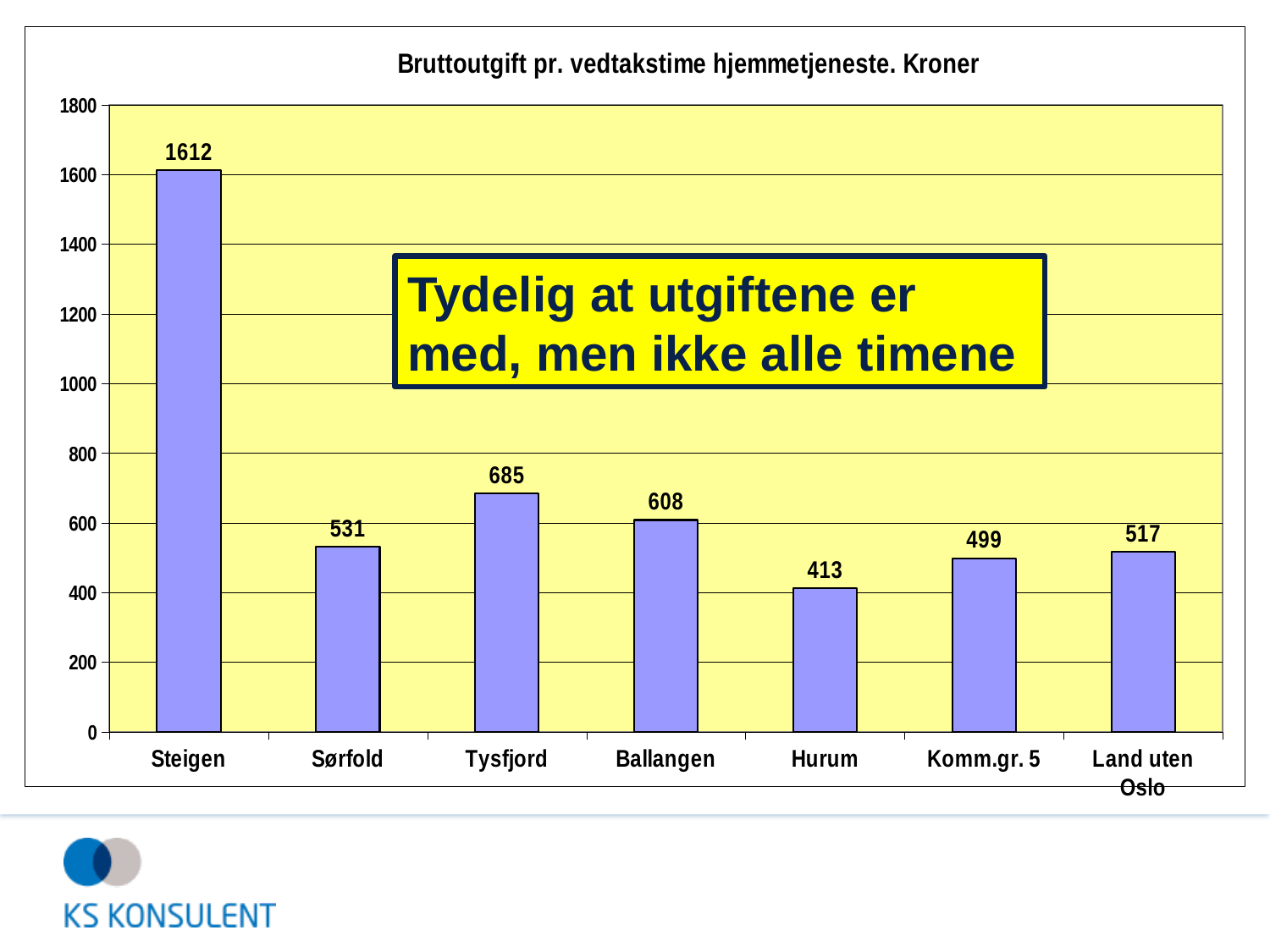
What is the value for Land uten Oslo? 517 What is the value for Hurum? 413 What is the value for Steigen? 1612 What is the difference between the values for Ballangen and Sørfold? 77 Which category has the highest value? Steigen What is the title of the chart? Bruttoutgift pr. vedtakstime hjemmetjeneste. Kroner What kind of chart is shown? Bar chart How many categories are shown on the x axis? 7 Which category has the lowest value? Hurum Which is larger, the value for Komm.gr. 5 or the value for Land uten Oslo? Land uten Oslo What is the difference between the values for Steigen and Tysfjord? 927 What is the value for Tysfjord? 685